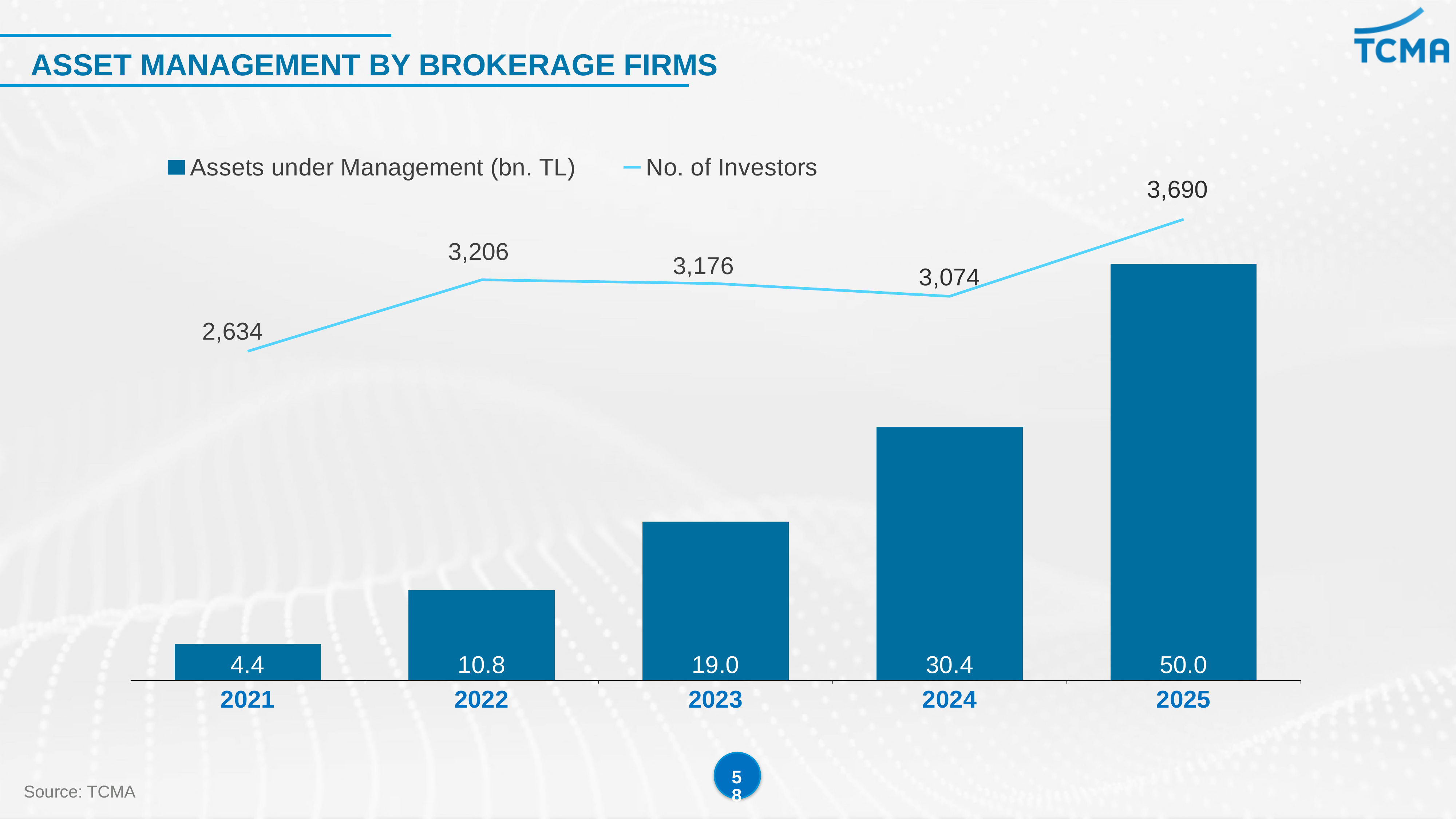
What is the difference in No. of Investors between 2022 and 2023? 30 Which year has more investors, 2023 or 2024? 2023 How many years are shown on the x axis? 5 What is the title of the chart on the slide? ASSET MANAGEMENT BY BROKERAGE FIRMS Which year has the lowest No. of Investors? 2021 How many series does the legend list? 2 What is the difference in Assets under Management (bn. TL) between 2025 and 2024? 19.6 Which year has the highest Assets under Management (bn. TL)? 2025 What is the value of Assets under Management (bn. TL) for 2025? 50.0 What is the No. of Investors for 2022? 3,206 Does Assets under Management (bn. TL) rise or fall from 2021 to 2025? rise What is the value of Assets under Management (bn. TL) for 2023? 19.0